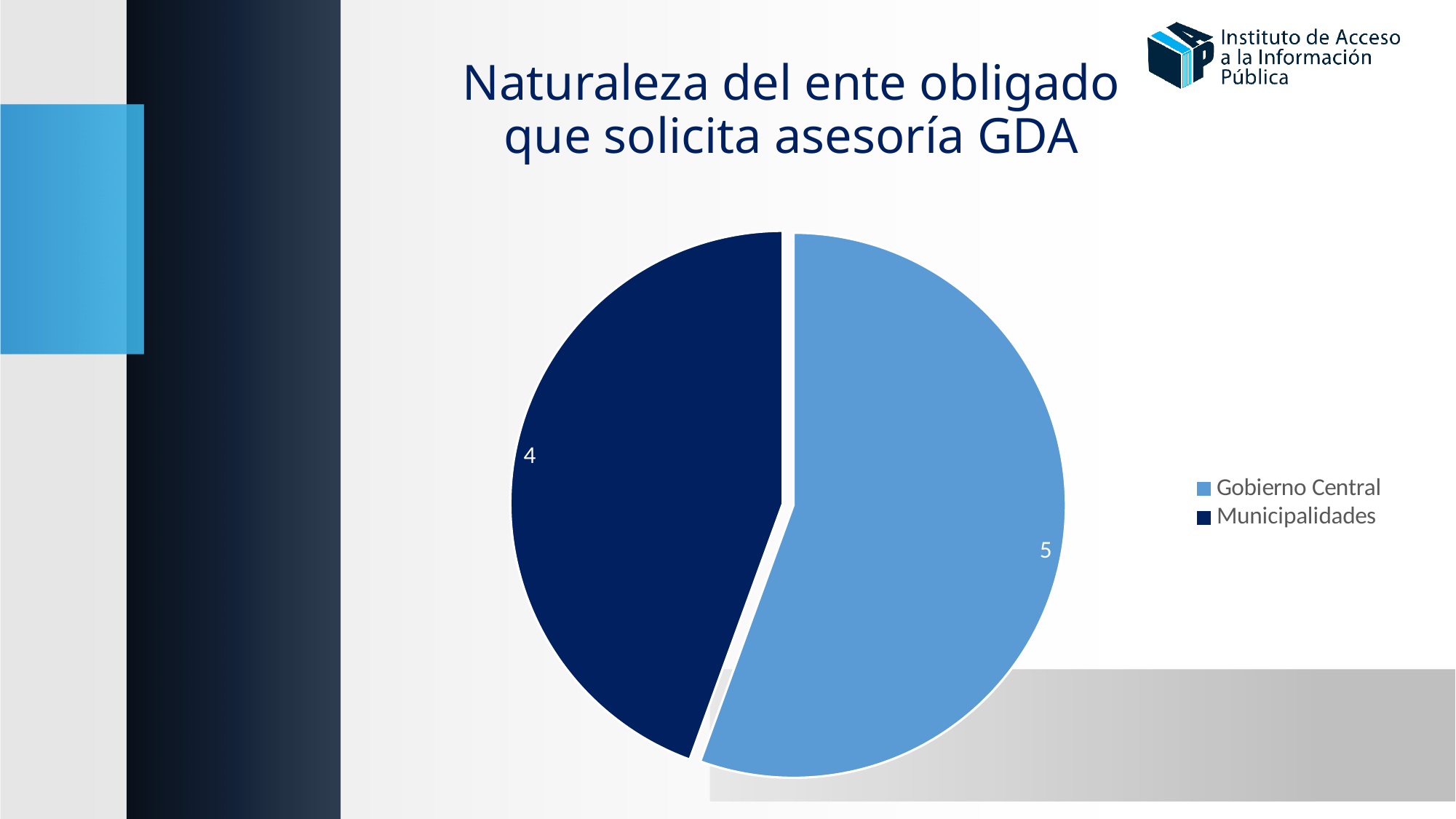
What is the value for Gobierno Central? 5 Which legend entry is shown in dark navy blue? Municipalidades What is the total of all slices in the pie chart? 9 What kind of chart is shown on the slide? Pie chart How many slices does the pie chart have? 2 What is the difference between the values for Gobierno Central and Municipalidades? 1 What is the title of the chart? Naturaleza del ente obligado que solicita asesoría GDA Which category has the smallest slice? Municipalidades How many entries does the legend list? 2 What is the value for Municipalidades? 4 Which is larger, Gobierno Central or Municipalidades? Gobierno Central Which category has the largest slice? Gobierno Central